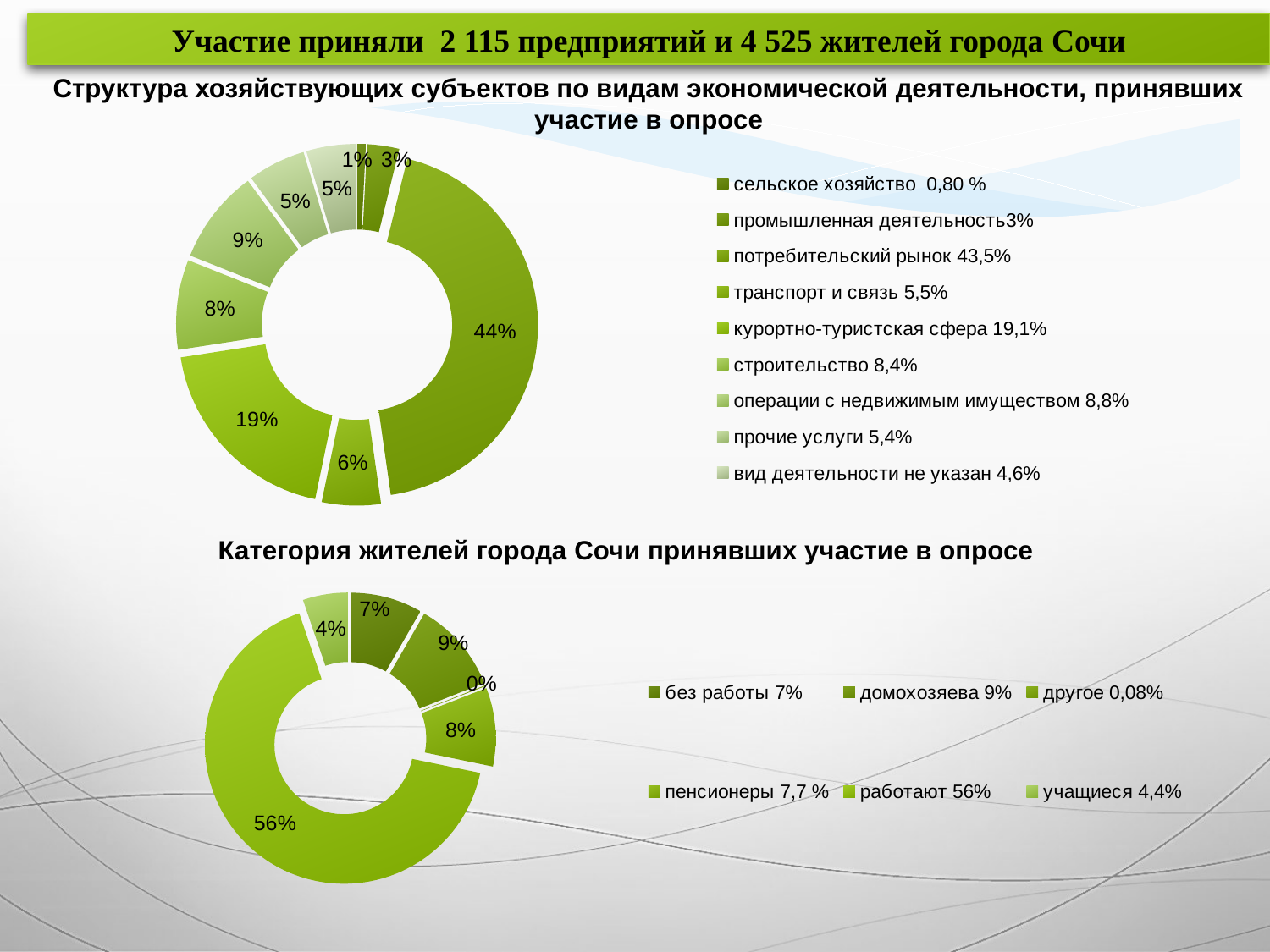
In the top chart, which category has the largest share? потребительский рынок What kind of chart is the top chart, 'Структура хозяйствующих субъектов по видам экономической деятельности'? doughnut (pie) chart In the top chart, which is larger: the share for операции с недвижимым имуществом or the share for транспорт и связь? операции с недвижимым имуществом In the bottom chart, which category has the largest share? работают In the top chart, which category has the smallest share? сельское хозяйство In the bottom chart, 'Категория жителей города Сочи принявших участие в опросе', what data label is shown on the slice for работают? 56% In the top chart, what value does the legend give for строительство? 8,4% In the bottom chart, what is the difference between the data labels for домохозяева (9%) and без работы (7%)? 2% In the top chart, what data label is shown on the slice for курортно-туристская сфера? 19% How many categories does the legend of the top chart list? 9 In the top chart, what data label is shown on the slice for потребительский рынок? 44% How many categories does the legend of the bottom chart list? 6